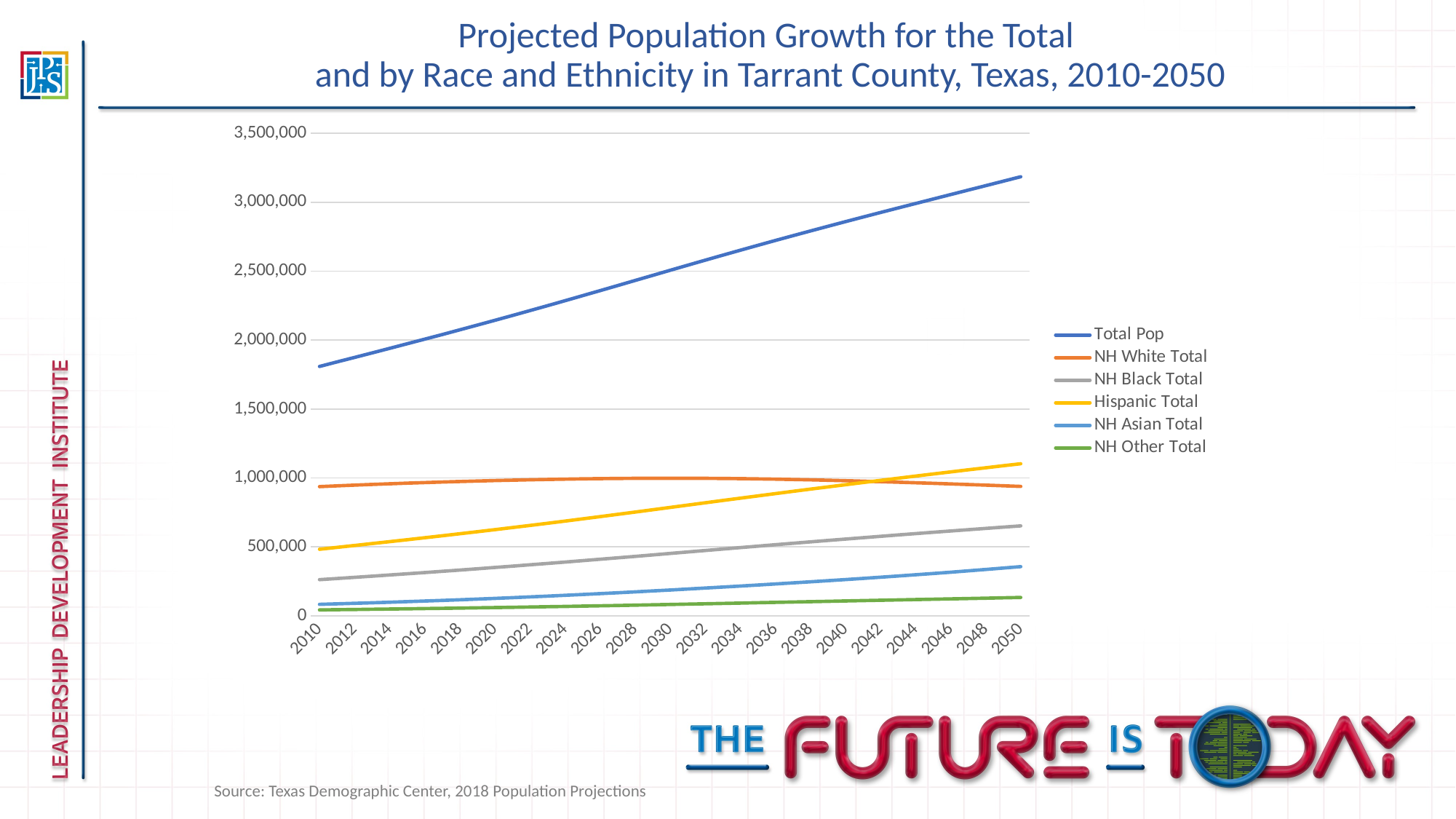
How many series does the legend list? 6 Does the Total Pop line rise or fall from 2010 to 2050? Rises What source is cited for the chart data? Texas Demographic Center, 2018 Population Projections Does the Hispanic Total line rise or fall from 2010 to 2050? Rises What kind of chart is shown on the slide? Line chart Is the value for Total Pop in 2050 greater or less than 3,000,000? greater How many years are labelled along the x axis? 21 Which series has the lowest value in 2050? NH Other Total Is the value for Total Pop in 2010 greater or less than 2,000,000? less In 2010, which is larger: NH White Total or Hispanic Total? NH White Total Is the value for NH Asian Total in 2050 greater or less than 500,000? less